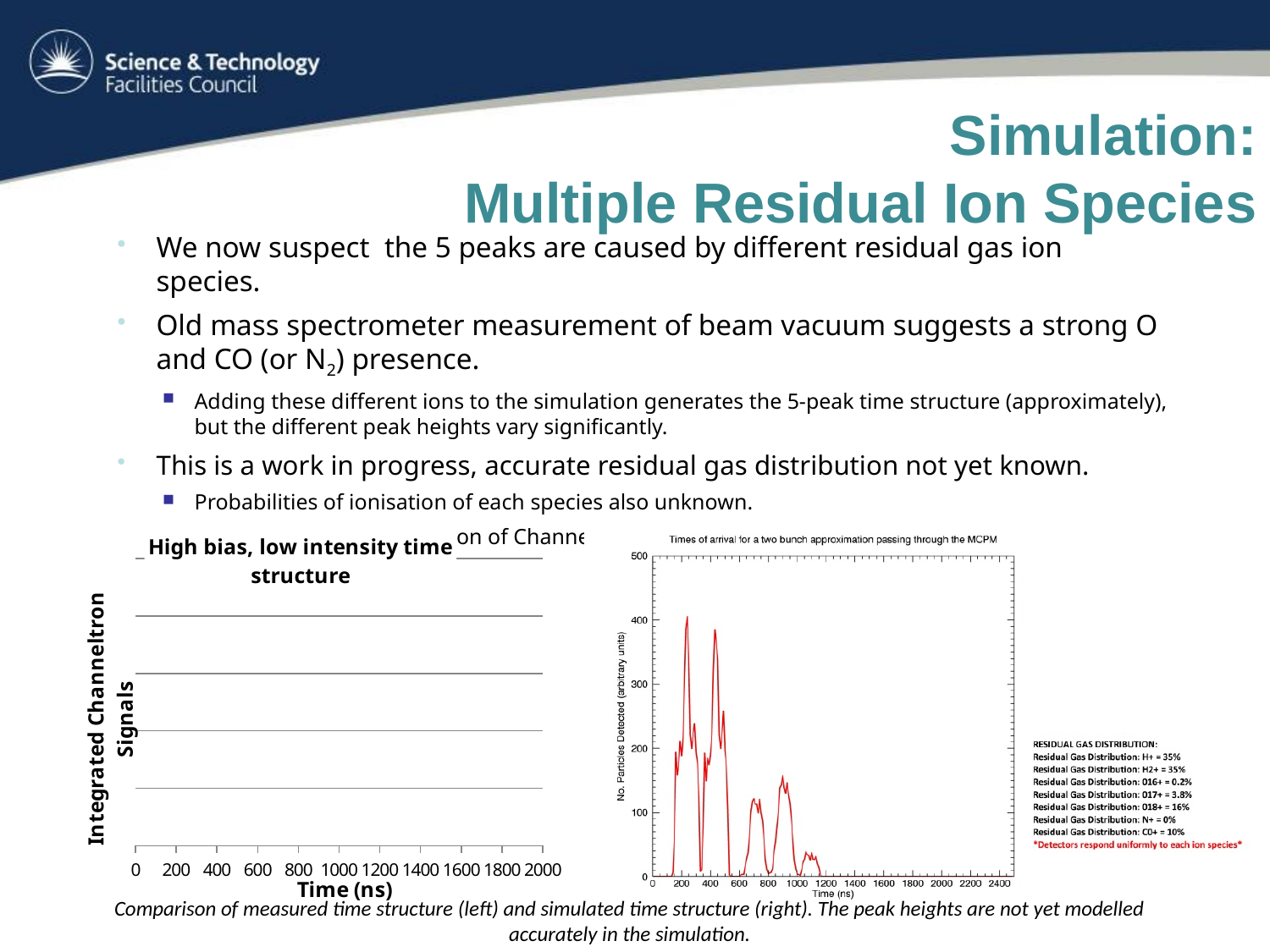
In the right-hand chart (times of arrival), which is larger: the peak near 200 ns or the peak near 900 ns? the peak near 200 ns In the right-hand chart (times of arrival), is the peak near 700 ns greater or less than 200 particles? less What is the title of the left-hand chart on the slide? High bias, low intensity time structure What kind of chart is the right-hand chart titled 'Times of arrival for a two bunch approximation passing through the MCPM'? line chart How many distinct peaks does the red curve in the right-hand chart (times of arrival) show? 5 In the right-hand chart (times of arrival), which is larger: the peak near 450 ns or the peak near 1100 ns? the peak near 450 ns According to the residual gas distribution annotation beside the right-hand chart, what percentage is given for H+? 35% In the right-hand chart (times of arrival), is the small peak near 1100 ns greater or less than 100 particles? less In the right-hand chart (times of arrival), is the peak near 450 ns greater or less than 300 particles? greater In the right-hand chart (times of arrival), do the peak heights generally rise or fall as time increases along the x axis? fall